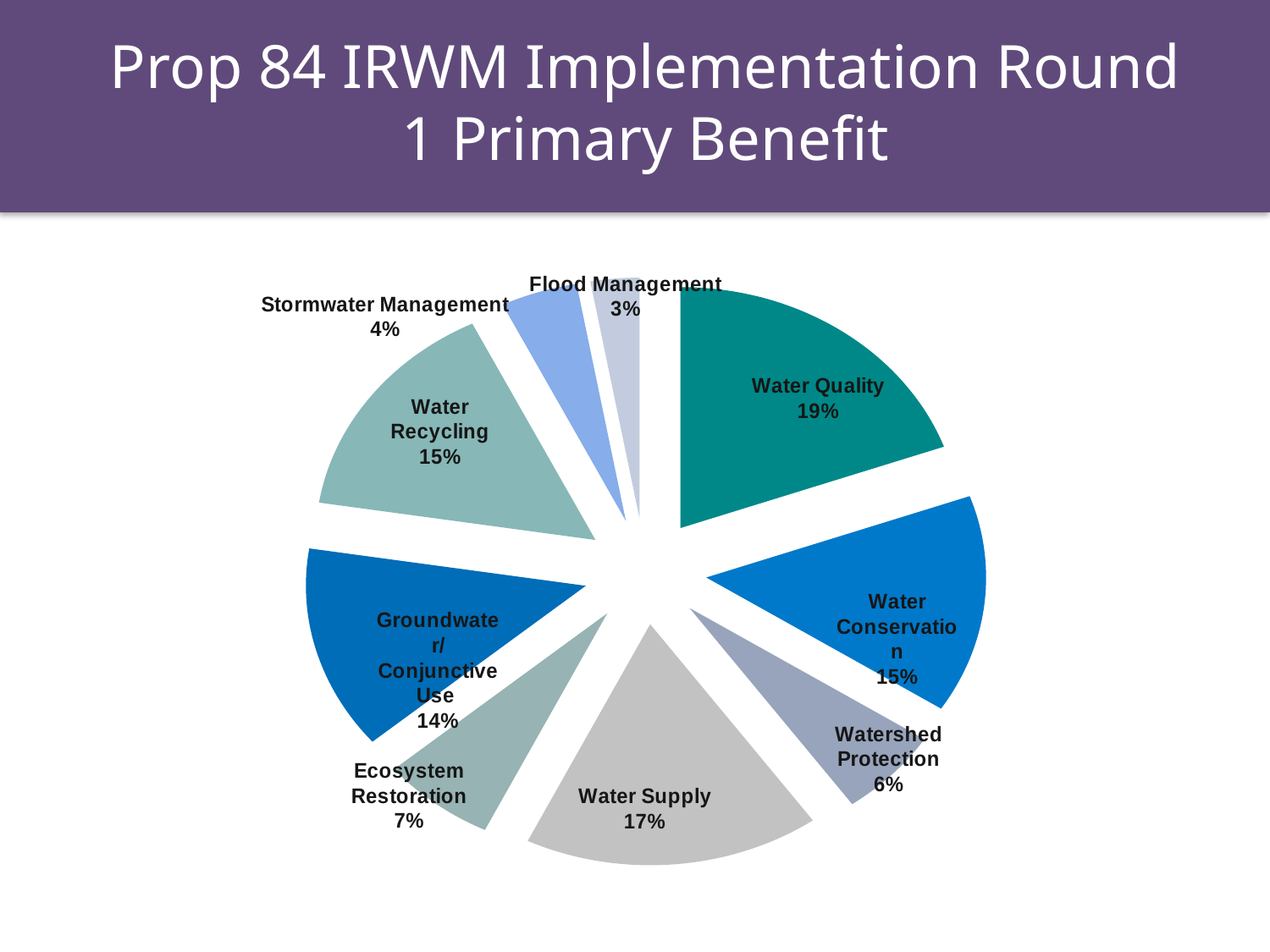
Which category has the largest share of the pie? Water Quality What is the value for Flood Management? 3% What is the value shown for Water Supply? 17% What is the combined share of Water Recycling and Water Conservation? 30% What kind of chart is shown on the slide? Pie chart What percentage is labelled for Groundwater/Conjunctive Use? 14% How many categories are shown in the pie chart? 9 What is the title of the slide containing the chart? Prop 84 IRWM Implementation Round 1 Primary Benefit Which is larger, Ecosystem Restoration or Watershed Protection? Ecosystem Restoration What is the difference between the Water Quality share and the Water Supply share? 2% Which category has the smallest share of the pie? Flood Management What share of the pie does Water Quality represent? 19%